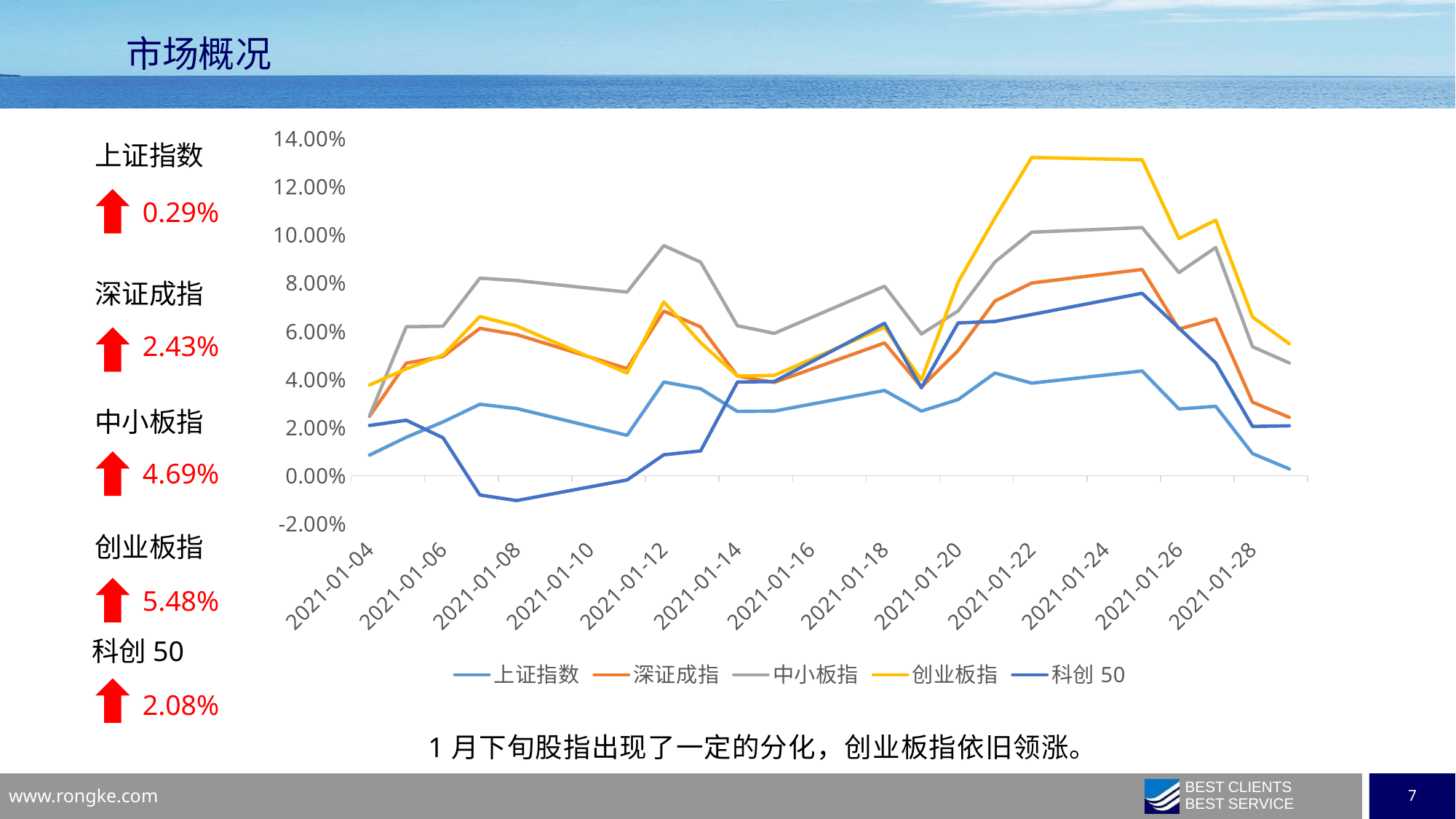
Does the 科创 50 line rise or fall between 2021-01-06 and 2021-01-08? fall Is the value for 科创 50 at 2021-01-08 greater or less than 0.00%? less Is the value for 创业板指 at 2021-01-22 greater or less than 12.00%? greater How many date labels are shown on the x axis of the chart? 13 Which series reaches the highest value anywhere on the chart? 创业板指 How many series does the chart legend list? 5 What kind of chart is shown on the slide? line chart Is the value for 上证指数 at 2021-01-04 greater or less than 2.00%? less Does the 创业板指 line rise or fall between 2021-01-20 and 2021-01-22? rise Which series is the lowest on the chart at 2021-01-08? 科创 50 At 2021-01-22, which is larger: 创业板指 or 上证指数? 创业板指 At 2021-01-08, which is larger: 中小板指 or 科创 50? 中小板指